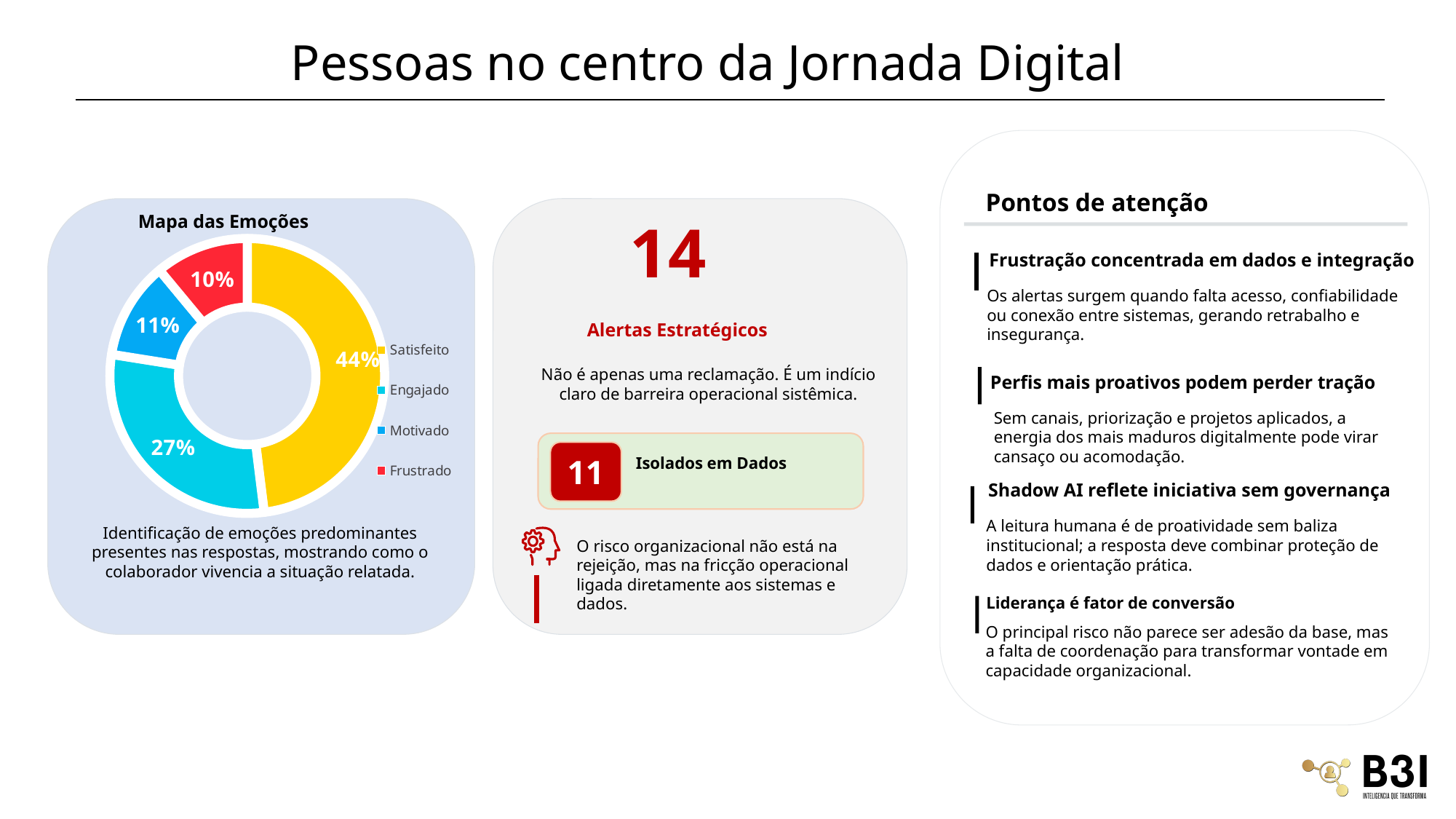
In the 'Mapa das Emoções' chart, what is the value for Frustrado? 10% In the 'Mapa das Emoções' chart, what is the value for Satisfeito? 44% In the 'Mapa das Emoções' chart, what colour is the Frustrado slice? Red In the 'Mapa das Emoções' chart, what is the value for Motivado? 11% What is the title of the chart on the slide? Mapa das Emoções What kind of chart is 'Mapa das Emoções'? Doughnut chart Which category has the largest share in the 'Mapa das Emoções' chart? Satisfeito How many categories does the 'Mapa das Emoções' chart show? 4 In the 'Mapa das Emoções' chart, which is larger, Engajado or Motivado? Engajado In the 'Mapa das Emoções' chart, what is the value for Engajado? 27% In the 'Mapa das Emoções' chart, what is the difference between Satisfeito and Engajado? 17% Which category has the smallest share in the 'Mapa das Emoções' chart? Frustrado